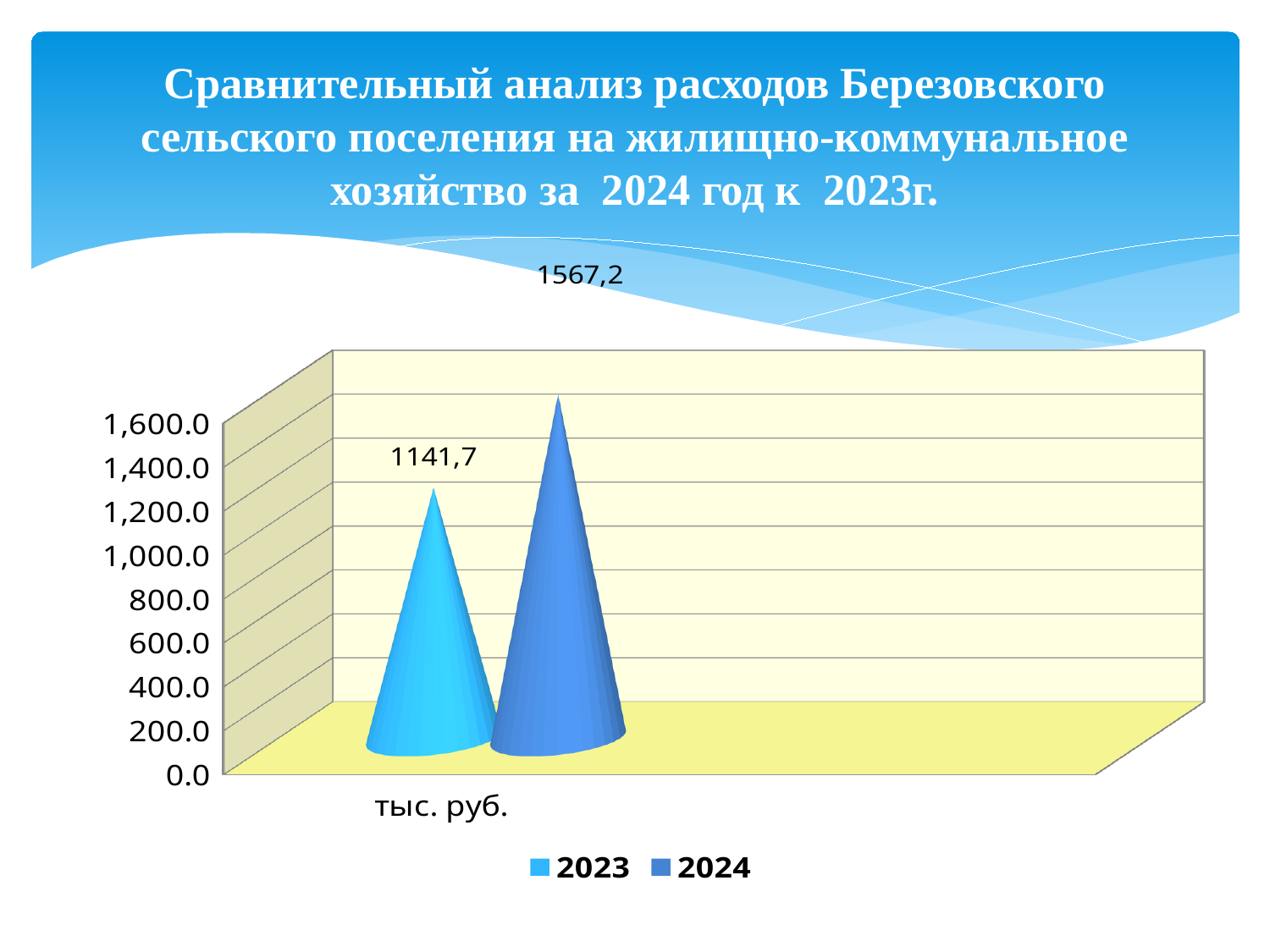
Which series has the lowest value? 2023 What is the value for the 2024 series? 1567,2 Is the value for 2024 greater or less than 1,400.0? greater What is the category label shown on the x axis? тыс. руб. Which series has the highest value? 2024 Which series has the higher value, 2023 or 2024? 2024 Which series is shown in the darker blue colour in the legend? 2024 What is the value for the 2023 series? 1141,7 Is the value for 2023 greater or less than 1,000.0? greater What is the difference between the 2024 value and the 2023 value? 425,5 What kind of chart is shown on the slide? bar chart How many series does the legend list? 2